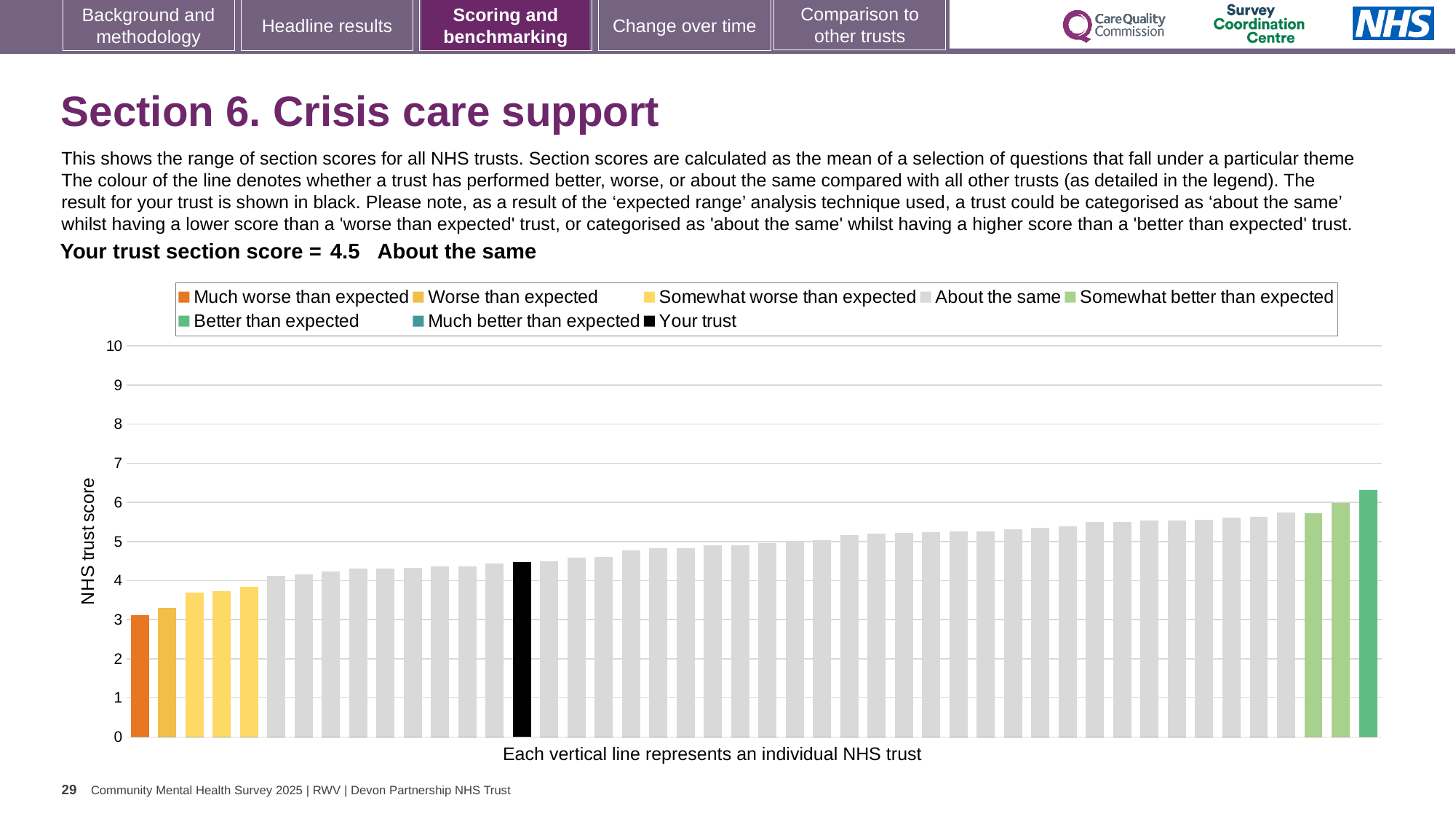
Which legend category does the shortest bar belong to? Much worse than expected Is the value of the black 'Your trust' bar greater or less than 5? less Is the value of the shortest bar greater or less than 4? less What is the section score for your trust shown on the slide? 4.5 How many bars are coloured as 'Somewhat worse than expected'? 3 Which legend category does the tallest bar belong to? Better than expected What is the label on the vertical axis of the chart? NHS trust score Which is higher, the black 'Your trust' bar or the orange 'Much worse than expected' bar? Your trust How many entries does the chart legend list? 8 Is the value of the tallest bar greater or less than 6? greater What kind of chart is shown on the slide? Bar chart Do the bar values rise or fall from left to right along the x axis? Rise